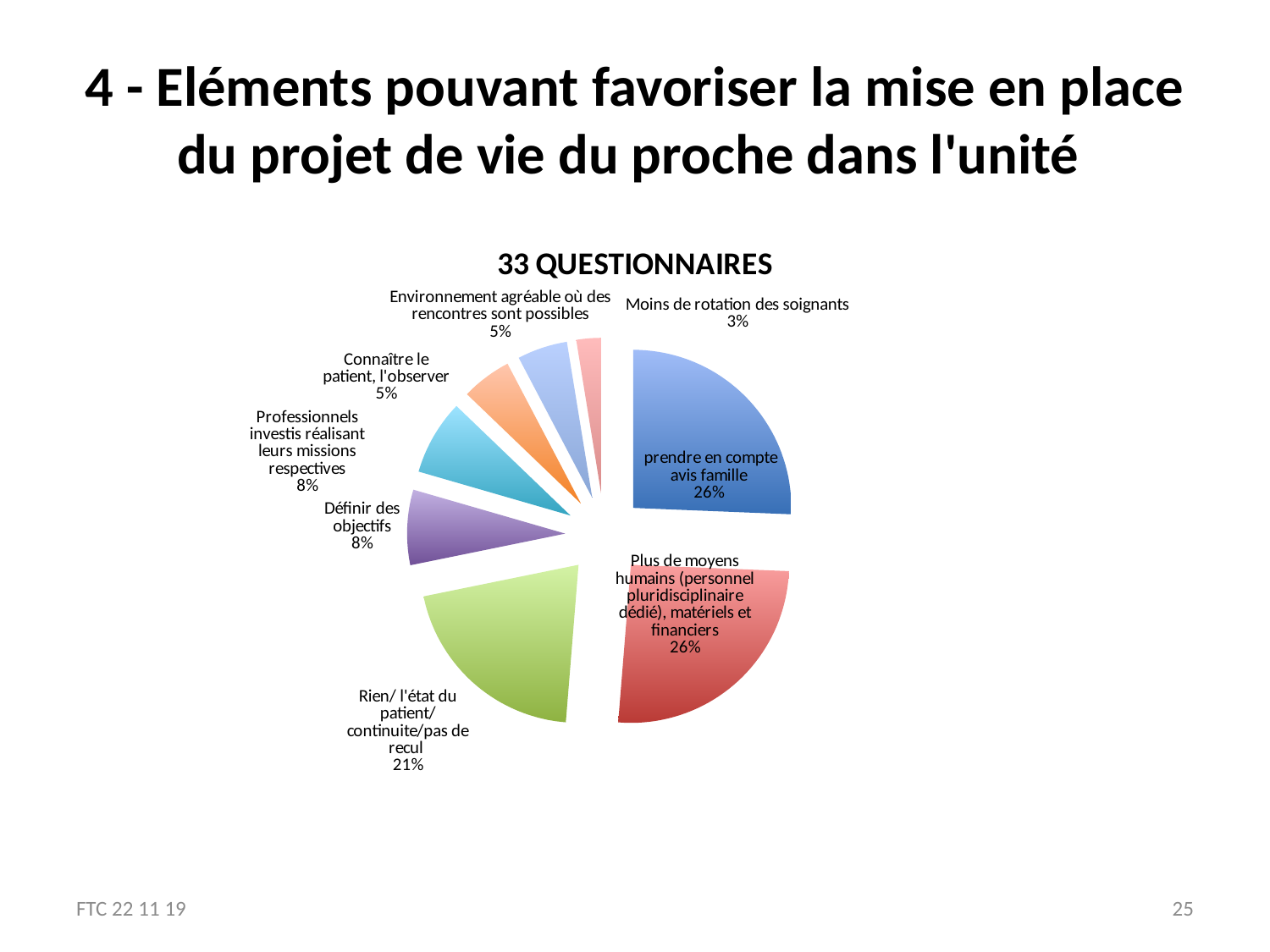
Which category has the smallest share of the pie? Moins de rotation des soignants What is the title of the chart? 33 QUESTIONNAIRES What share of the pie is "prendre en compte avis famille"? 26% What is the difference in percentage points between "Plus de moyens humains (personnel pluridisciplinaire dédié), matériels et financiers" and "Rien/ l'état du patient/ continuite/pas de recul"? 5 What share of the pie is "Rien/ l'état du patient/ continuite/pas de recul"? 21% What percentage is shown for "Connaître le patient, l'observer"? 5% What colour is the slice for "prendre en compte avis famille"? blue What percentage is shown for "Définir des objectifs"? 8% What kind of chart is shown on the slide? pie chart What is the difference in percentage points between "prendre en compte avis famille" and "Moins de rotation des soignants"? 23 How many slices does the pie chart have? 8 Which is larger: the share for "Professionnels investis réalisant leurs missions respectives" or the share for "Environnement agréable où des rencontres sont possibles"? Professionnels investis réalisant leurs missions respectives